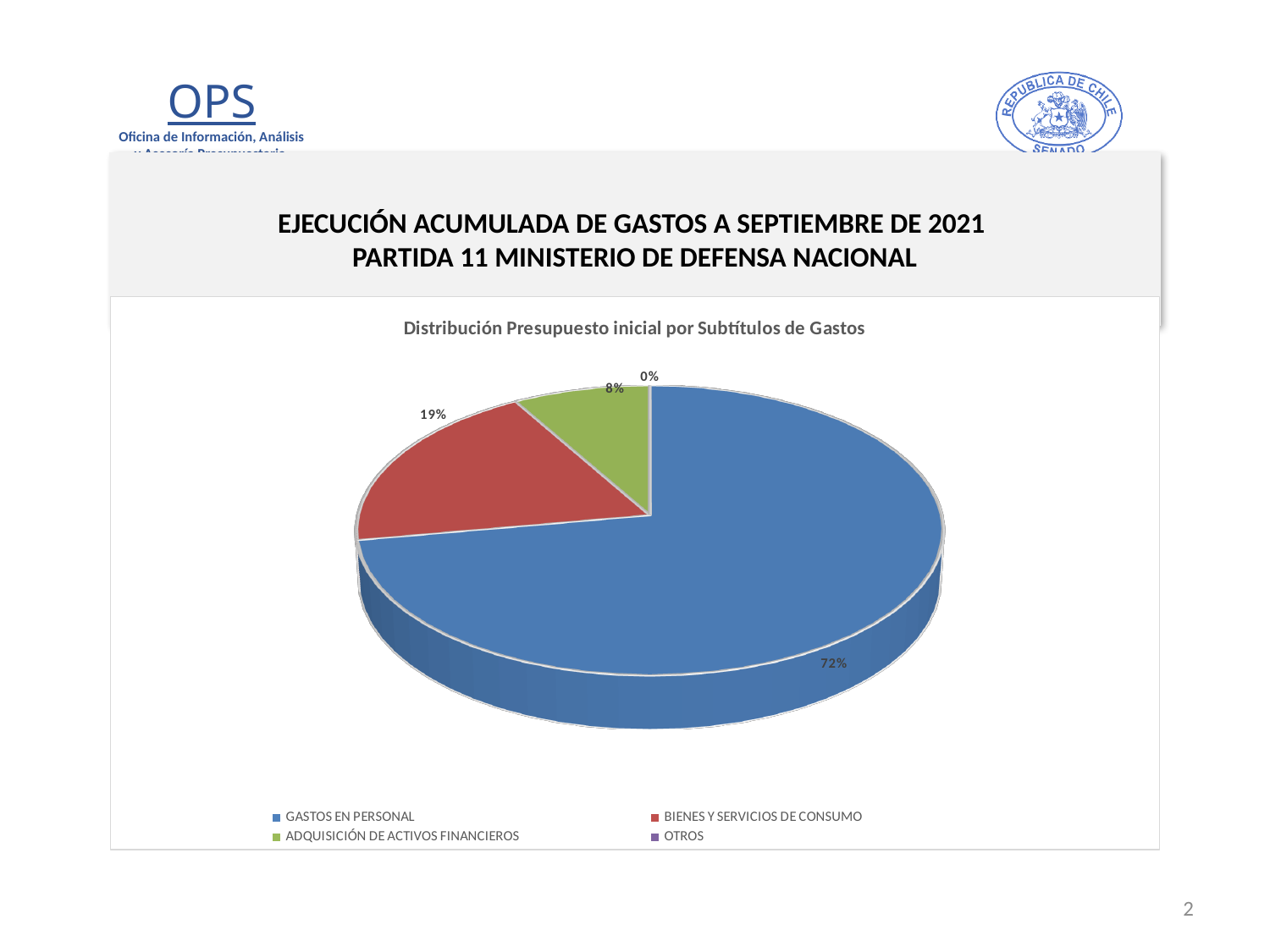
What is the difference in percentage points between GASTOS EN PERSONAL and BIENES Y SERVICIOS DE CONSUMO? 53 percentage points What share of the pie does OTROS represent? 0% What kind of chart is shown on the slide? Pie chart What colour is the slice for BIENES Y SERVICIOS DE CONSUMO? Red Which category has the largest share of the pie? GASTOS EN PERSONAL Which category has the smallest share of the pie? OTROS What share of the pie does GASTOS EN PERSONAL represent? 72% Which is larger, the share for BIENES Y SERVICIOS DE CONSUMO or the share for ADQUISICIÓN DE ACTIVOS FINANCIEROS? BIENES Y SERVICIOS DE CONSUMO How many categories does the legend list? 4 What share of the pie does BIENES Y SERVICIOS DE CONSUMO represent? 19% What is the title of the chart? Distribución Presupuesto inicial por Subtítulos de Gastos